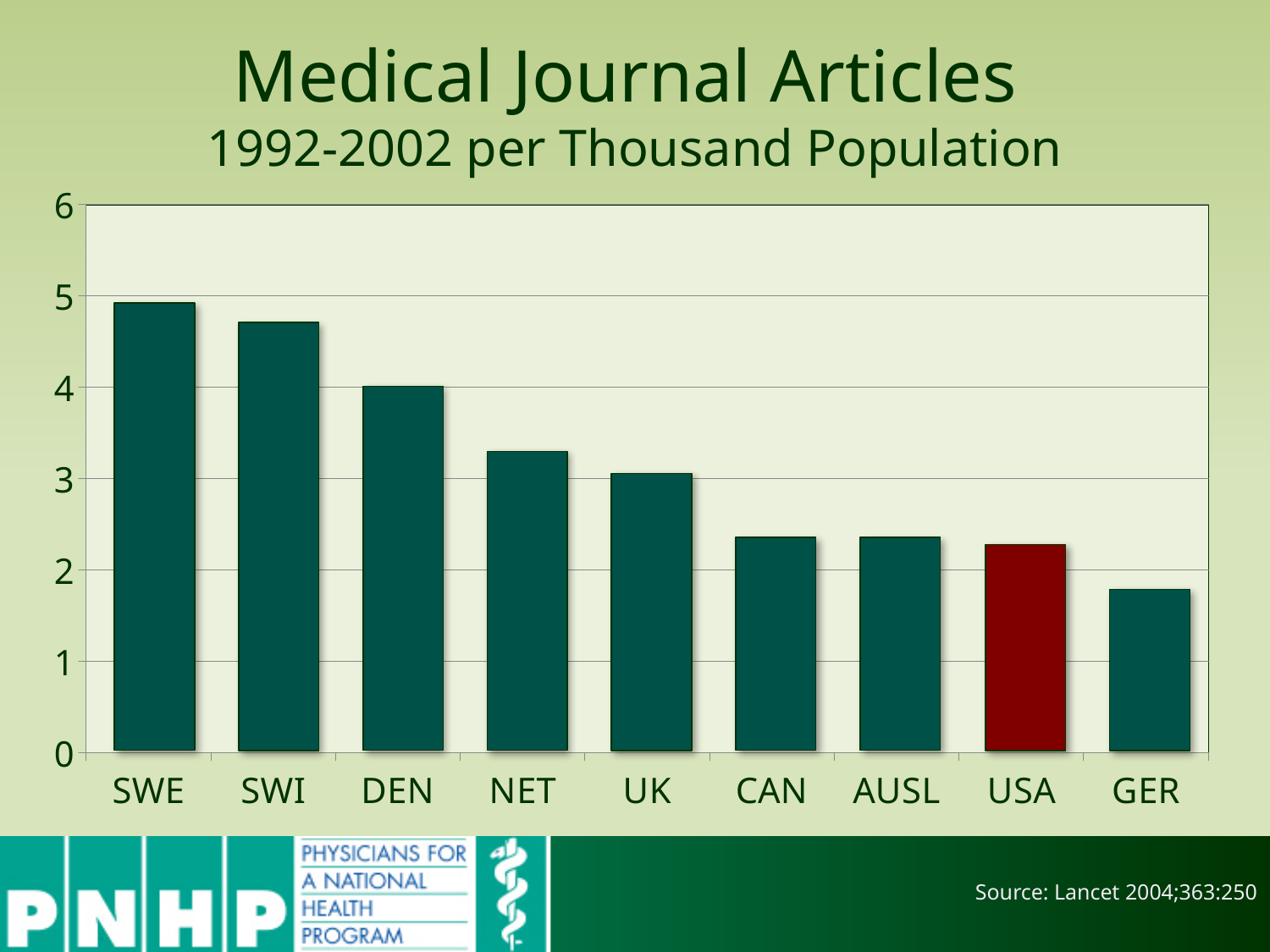
Is the value for GER greater or less than 2? less Is the value for NET greater or less than 3? greater Which country has the highest number of medical journal articles per thousand population? SWE Is the value for CAN greater or less than 3? less What kind of chart is shown on the slide? bar chart Which country has the lowest number of medical journal articles per thousand population? GER Which country's bar is coloured red instead of dark green? USA Do the values generally rise or fall moving from left to right along the x axis? fall Which has a larger value, NET or USA? NET How many countries are shown on the x axis of the chart? 9